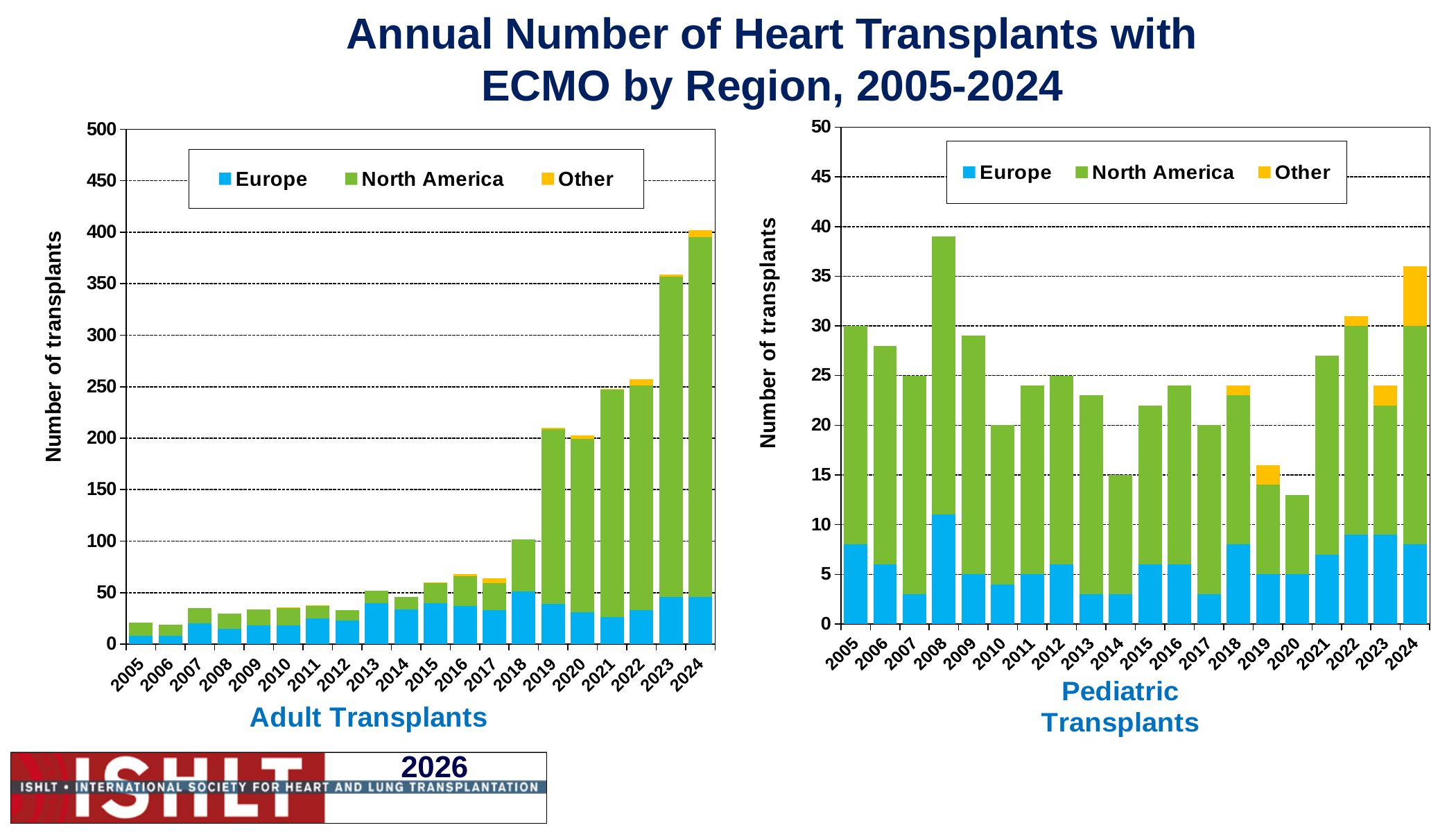
In the Adult Transplants chart, which year has the highest total number of transplants? 2024 What kind of chart is the Adult Transplants chart? Stacked bar chart How many series does the legend of the Pediatric Transplants chart list? 3 In the Pediatric Transplants chart, is the total for 2021 greater or less than 25? greater In the Adult Transplants chart, how many years are shown on the x axis? 20 In the Adult Transplants chart, is the total for 2024 greater or less than 350? greater In the Adult Transplants chart, is the total for 2023 greater or less than 300? greater In the Pediatric Transplants chart, which year has the highest total number of transplants? 2008 In the Adult Transplants chart, do the total values generally rise or fall from 2005 to 2024? Rise In the Pediatric Transplants chart, which year has the lowest total number of transplants? 2020